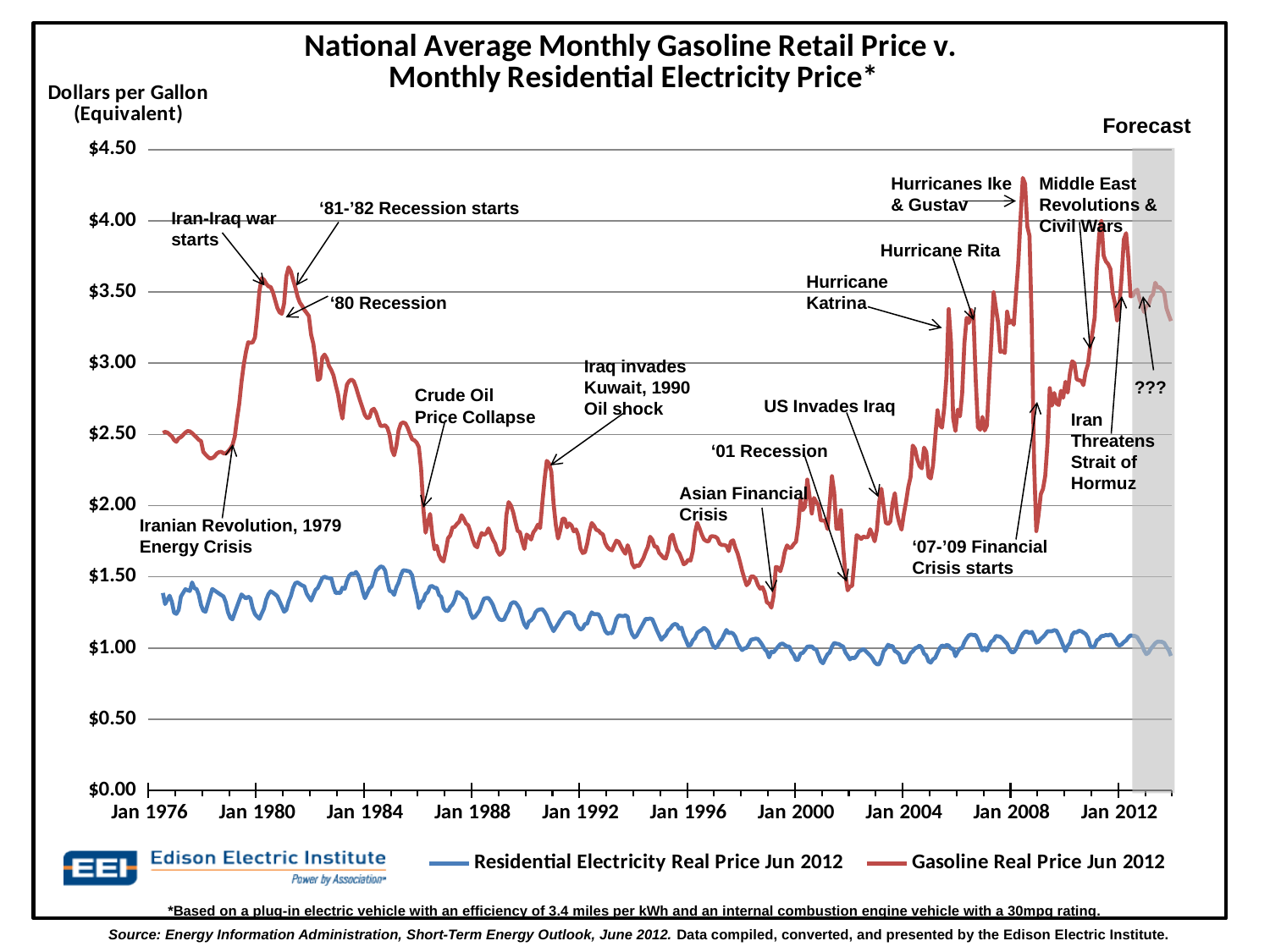
What kind of chart is shown on the slide? Line chart At Jan 2008, which series has the higher value, Gasoline Real Price or Residential Electricity Real Price? Gasoline Real Price Jun 2012 Is the Residential Electricity Real Price around Jan 2000 greater or less than $1.50? less Is the gasoline price at the Hurricanes Ike & Gustav peak greater or less than $4.00? greater How many series does the legend list? 2 Which colour is used for the Gasoline Real Price Jun 2012 series? Red Is the gasoline price at the '01 Recession low point greater or less than $2.00? less What is the title of the chart? National Average Monthly Gasoline Retail Price v. Monthly Residential Electricity Price* Does the Residential Electricity Real Price line generally rise or fall between Jan 1984 and Jan 2000? fall Which annotated event marks the highest peak of the gasoline price line? Hurricanes Ike & Gustav Which series reaches the highest value on the chart? Gasoline Real Price Jun 2012